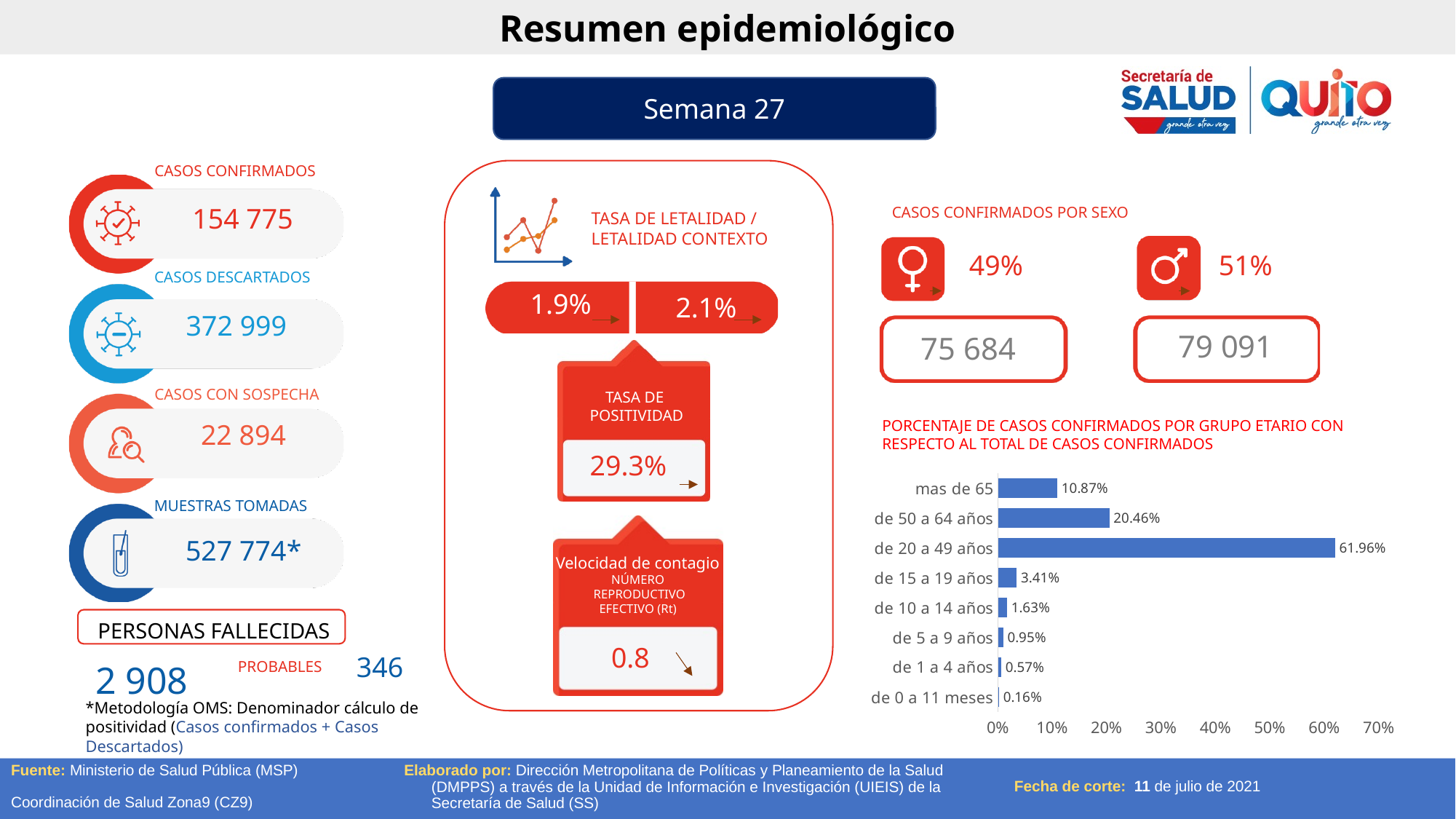
What is the difference between the percentages for 'de 50 a 64 años' and 'mas de 65' in the bar chart? 9.59% What percentage is shown for the 'de 0 a 11 meses' group in the bar chart? 0.16% What percentage of confirmed cases does the bar chart show for the 'de 20 a 49 años' age group? 61.96% In the bar chart, which is larger: the value for 'de 10 a 14 años' or 'de 5 a 9 años'? de 10 a 14 años Which age group has the lowest percentage of confirmed cases in the bar chart? de 0 a 11 meses Which age group has the highest percentage of confirmed cases in the bar chart? de 20 a 49 años What value is shown for 'mas de 65' in the bar chart? 10.87% Is the value for 'de 50 a 64 años' in the bar chart greater or less than 30%? less What value does the bar chart show for 'de 15 a 19 años'? 3.41% What type of chart is used to show the percentage of confirmed cases by age group? Bar chart How many age groups are shown in the bar chart? 8 What is the highest value shown on the horizontal axis of the bar chart? 70%